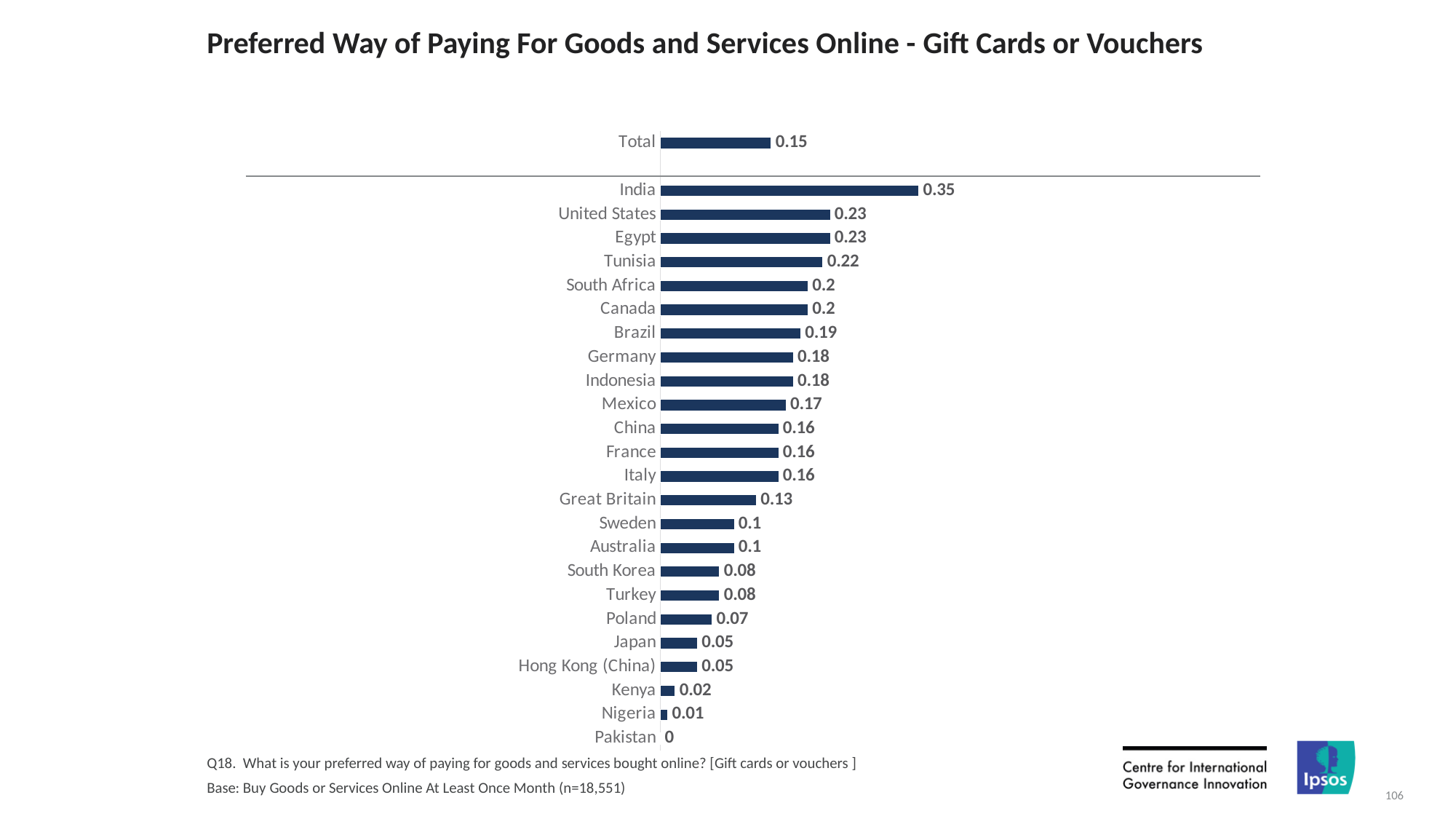
Which has a larger value, Brazil or Poland? Brazil What is the value for Kenya? 0.02 What is the title of the chart? Preferred Way of Paying For Goods and Services Online - Gift Cards or Vouchers What is the value for India? 0.35 What is the value for Great Britain? 0.13 Which country has the lowest value? Pakistan What is the difference between the values for India and the United States? 0.12 How many countries (excluding Total) are shown in the chart? 24 What is the difference between the values for Tunisia and Sweden? 0.12 Which country has the highest value? India What is the value for Total? 0.15 What type of chart is shown on the slide? Bar chart